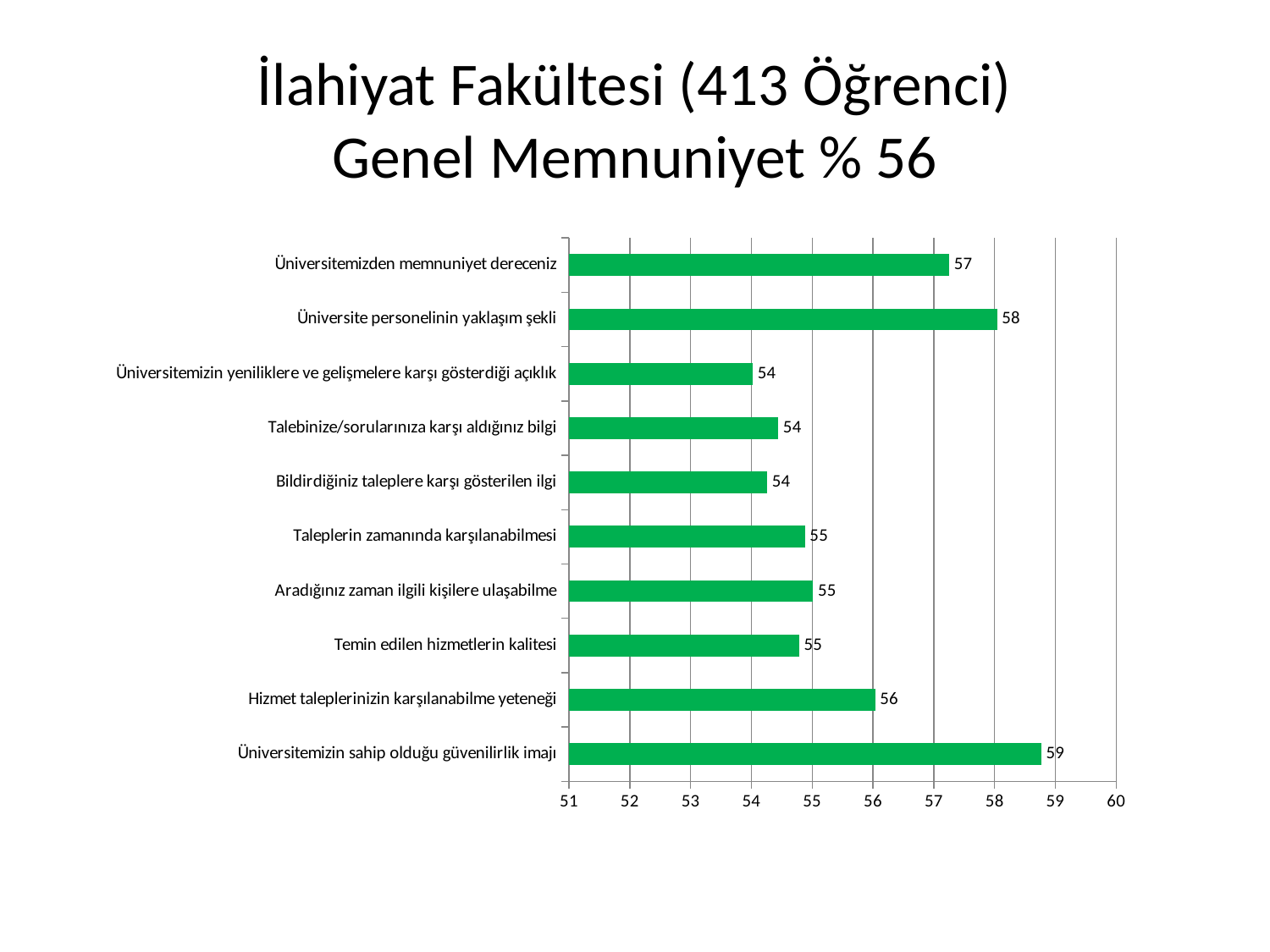
What is the value for "Üniversitemizden memnuniyet dereceniz"? 57 What is the title of the slide? İlahiyat Fakültesi (413 Öğrenci) Genel Memnuniyet % 56 What kind of chart is shown on the slide? bar chart Which category has the highest value? Üniversitemizin sahip olduğu güvenilirlik imajı What is the value for "Hizmet taleplerinizin karşılanabilme yeteneği"? 56 Is the value for "Üniversitemizin yeniliklere ve gelişmelere karşı gösterdiği açıklık" greater or less than 56? less What is the value for "Üniversite personelinin yaklaşım şekli"? 58 What is the difference between the values for "Üniversitemizin sahip olduğu güvenilirlik imajı" and "Üniversitemizden memnuniyet dereceniz"? 2 How many categories does the chart show? 10 What is the value for "Taleplerin zamanında karşılanabilmesi"? 55 What is the value for "Üniversitemizin sahip olduğu güvenilirlik imajı"? 59 Which is larger, the value for "Üniversite personelinin yaklaşım şekli" or the value for "Hizmet taleplerinizin karşılanabilme yeteneği"? Üniversite personelinin yaklaşım şekli